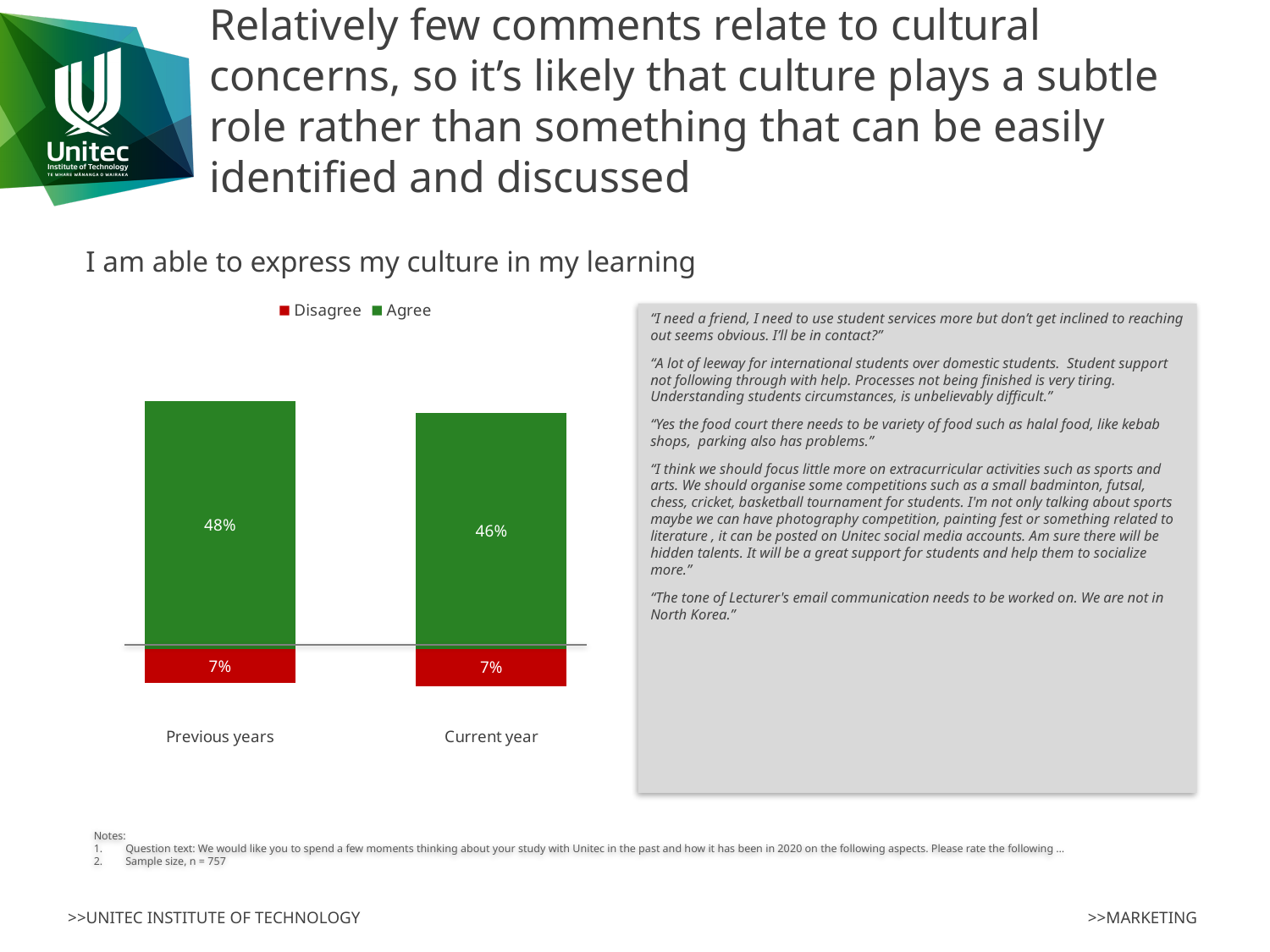
What is the difference between the Agree values for Previous years and Current year? 2% What colour represents the Disagree series in the chart? red What is the Agree value for Previous years? 48% Which category has the higher Agree value? Previous years What is the Disagree value for Previous years? 7% How many series does the chart legend list? 2 How many categories are shown on the x axis of the chart? 2 Does the Agree value rise or fall from Previous years to Current year? fall What is the Agree value for Current year? 46% What is the Disagree value for Current year? 7% What kind of chart is shown on the slide? bar chart Is the Agree value for Previous years larger or smaller than the Agree value for Current year? larger